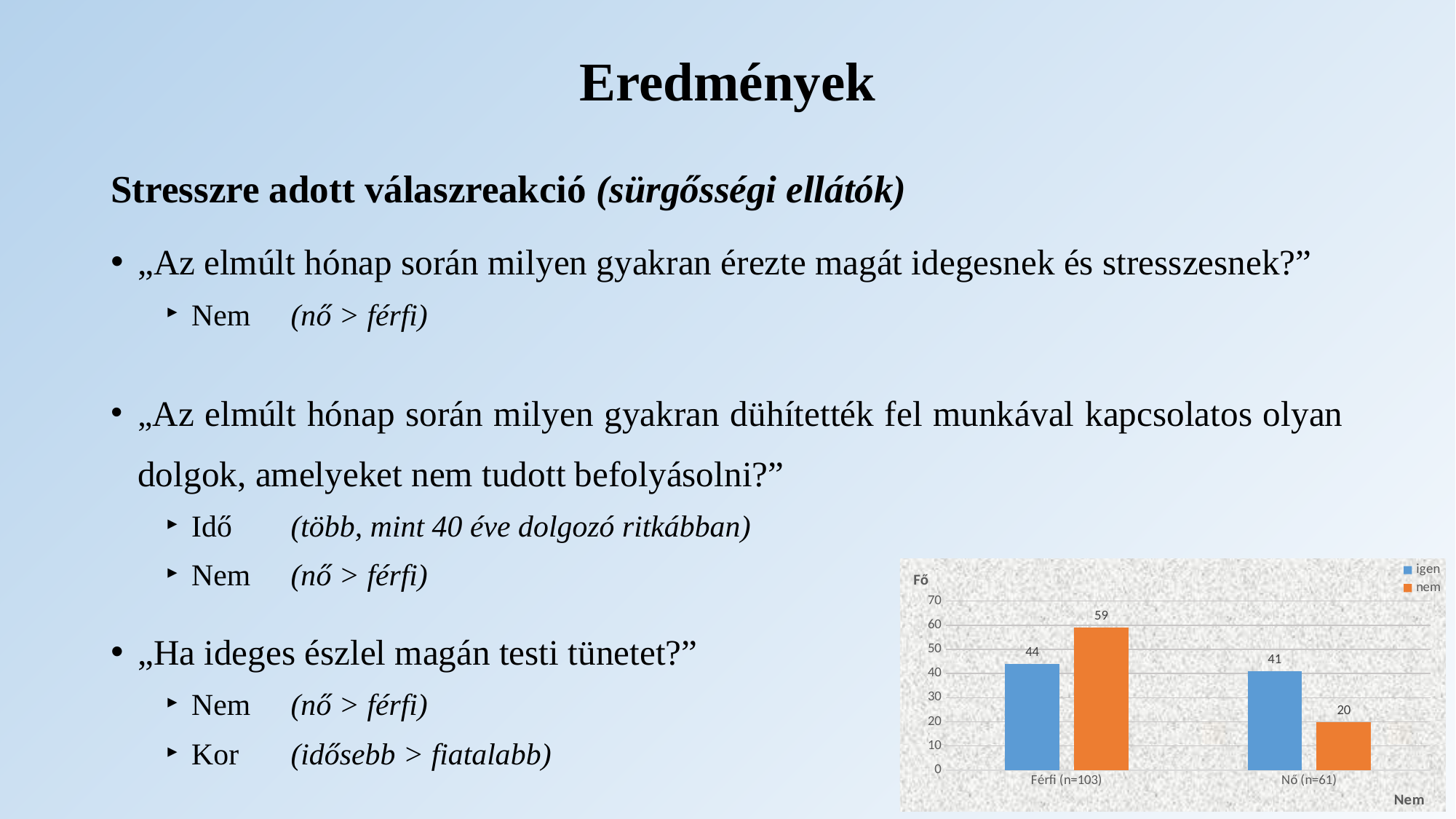
How many series does the chart legend list? 2 What is the value of the 'igen' bar for Férfi (n=103)? 44 Which bar in the chart has the highest value? nem for Férfi (n=103) What kind of chart is shown on the slide? bar chart What is the label of the vertical axis of the chart? Fő What is the value of the 'igen' bar for Nő (n=61)? 41 What is the value of the 'nem' bar for Férfi (n=103)? 59 Which is larger for Nő (n=61): the 'igen' value or the 'nem' value? igen How many categories are shown on the x axis of the chart? 2 What is the difference between the 'nem' values for Férfi (n=103) and Nő (n=61)? 39 What is the value of the 'nem' bar for Nő (n=61)? 20 Which bar in the chart has the lowest value? nem for Nő (n=61)